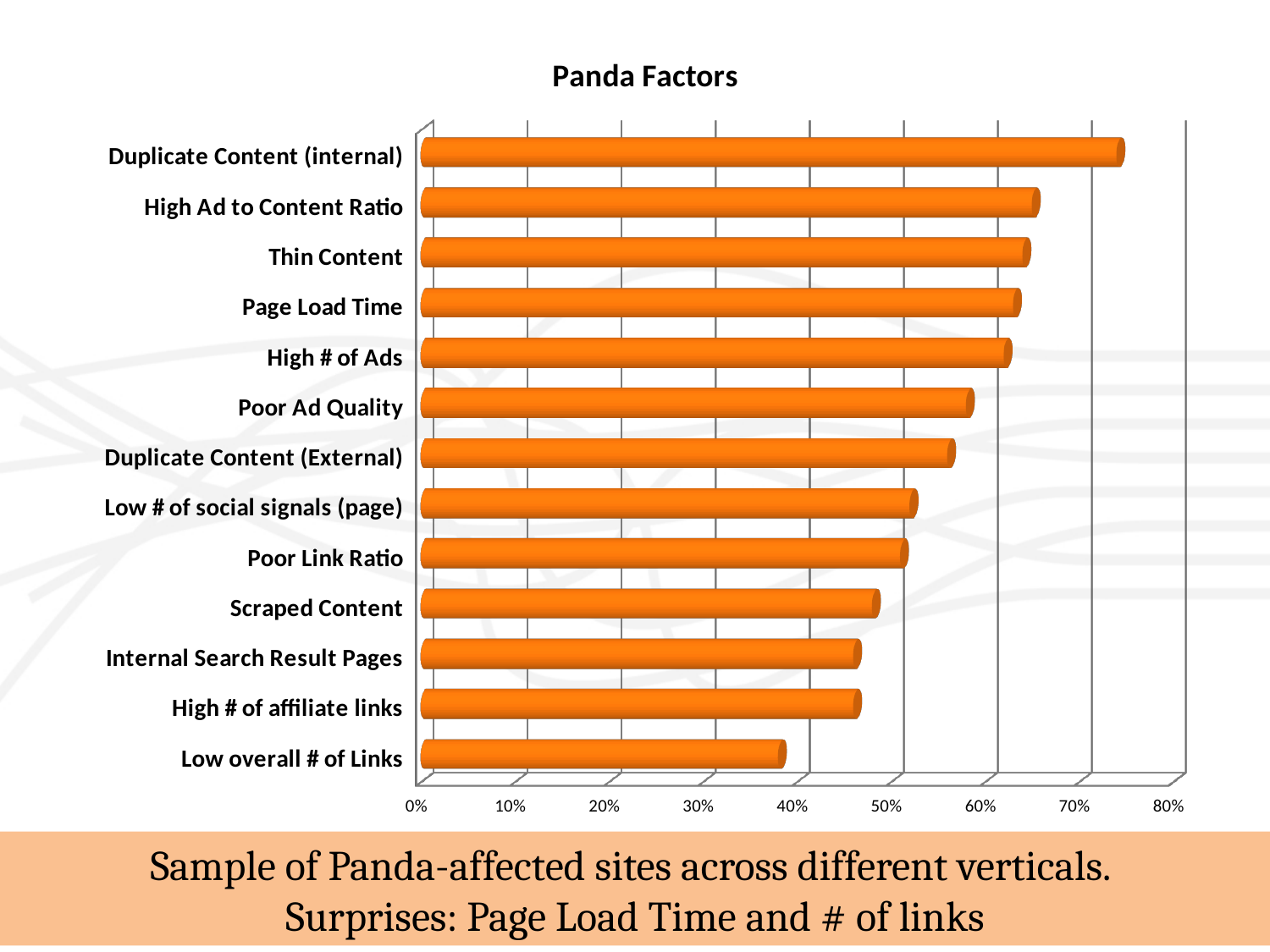
How many factors (categories) are plotted in the chart? 13 Is the value for Duplicate Content (internal) greater or less than 70%? greater Is the value for Low overall # of Links greater or less than 40%? less Which is larger, the value for Poor Ad Quality or the value for Scraped Content? Poor Ad Quality What is the title of the chart? Panda Factors Which is larger, the value for Duplicate Content (External) or the value for Thin Content? Thin Content Is the value for Scraped Content greater or less than 50%? less Which factor has the lowest value? Low overall # of Links What kind of chart is shown on the slide? bar chart Which factor has the highest value? Duplicate Content (internal)